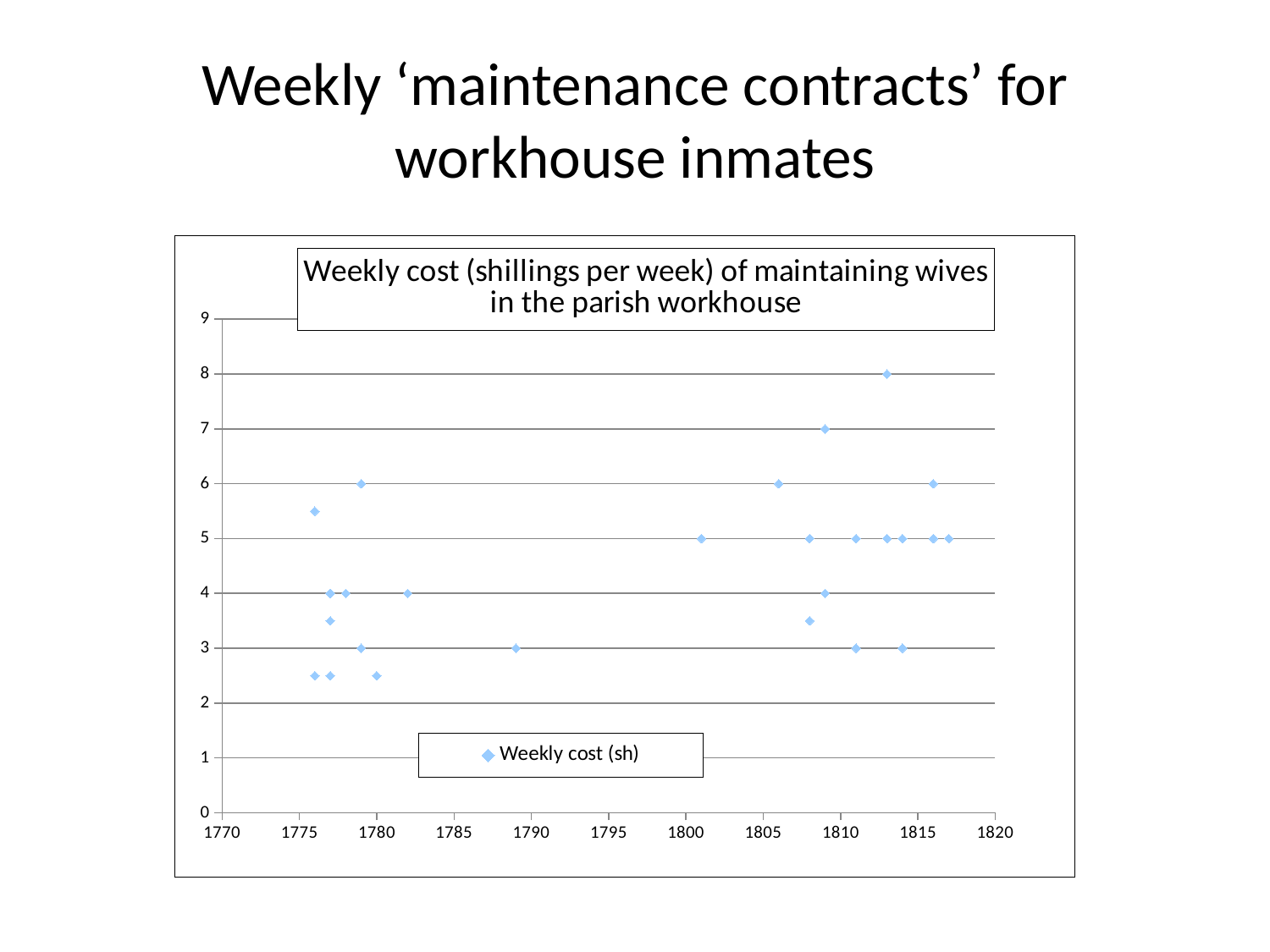
Is the lowest plotted weekly cost greater or less than 3? less What is the title printed inside the chart area? Weekly cost (shillings per week) of maintaining wives in the parish workhouse What is the legend entry for the plotted series? Weekly cost (sh) What is the weekly cost of the point plotted nearest to 1800? 5 Do the plotted weekly costs tend to be higher in the years after 1800 or in the years before 1790? after 1800 Is the highest plotted weekly cost greater or less than 7? greater Is the weekly cost of the point plotted nearest to 1790 greater or less than 4? less What is the highest weekly cost plotted on the chart? 8 How many series does the legend list? 1 Is the highest weekly cost plotted after 1810 larger or smaller than the highest weekly cost plotted before 1780? larger What kind of chart is shown on the slide? scatter chart